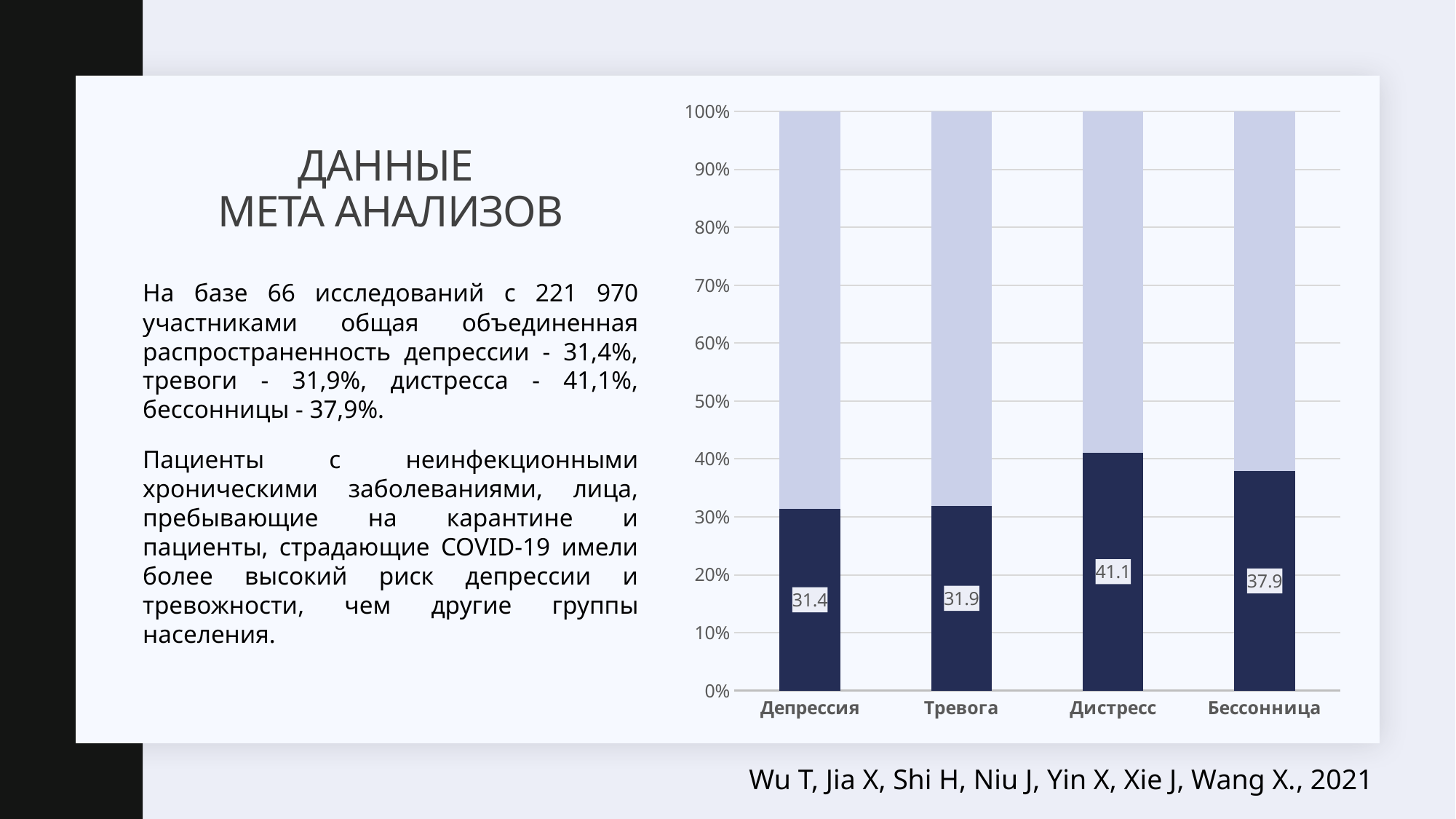
What kind of chart is shown on the slide? Stacked bar chart Which category has the highest labelled value? Дистресс What is the labelled value for Депрессия? 31.4 Which category has the lowest labelled value? Депрессия What is the labelled value for Дистресс? 41.1 What colour is the lower segment of each bar? Dark navy blue Which has the larger labelled value, Дистресс or Бессонница? Дистресс What is the difference between the labelled values for Дистресс and Бессонница? 3.2 What is the labelled value for Бессонница? 37.9 What is the labelled value for Тревога? 31.9 Is the dark segment for Дистресс greater or less than 40%? greater How many categories are shown on the x axis? 4